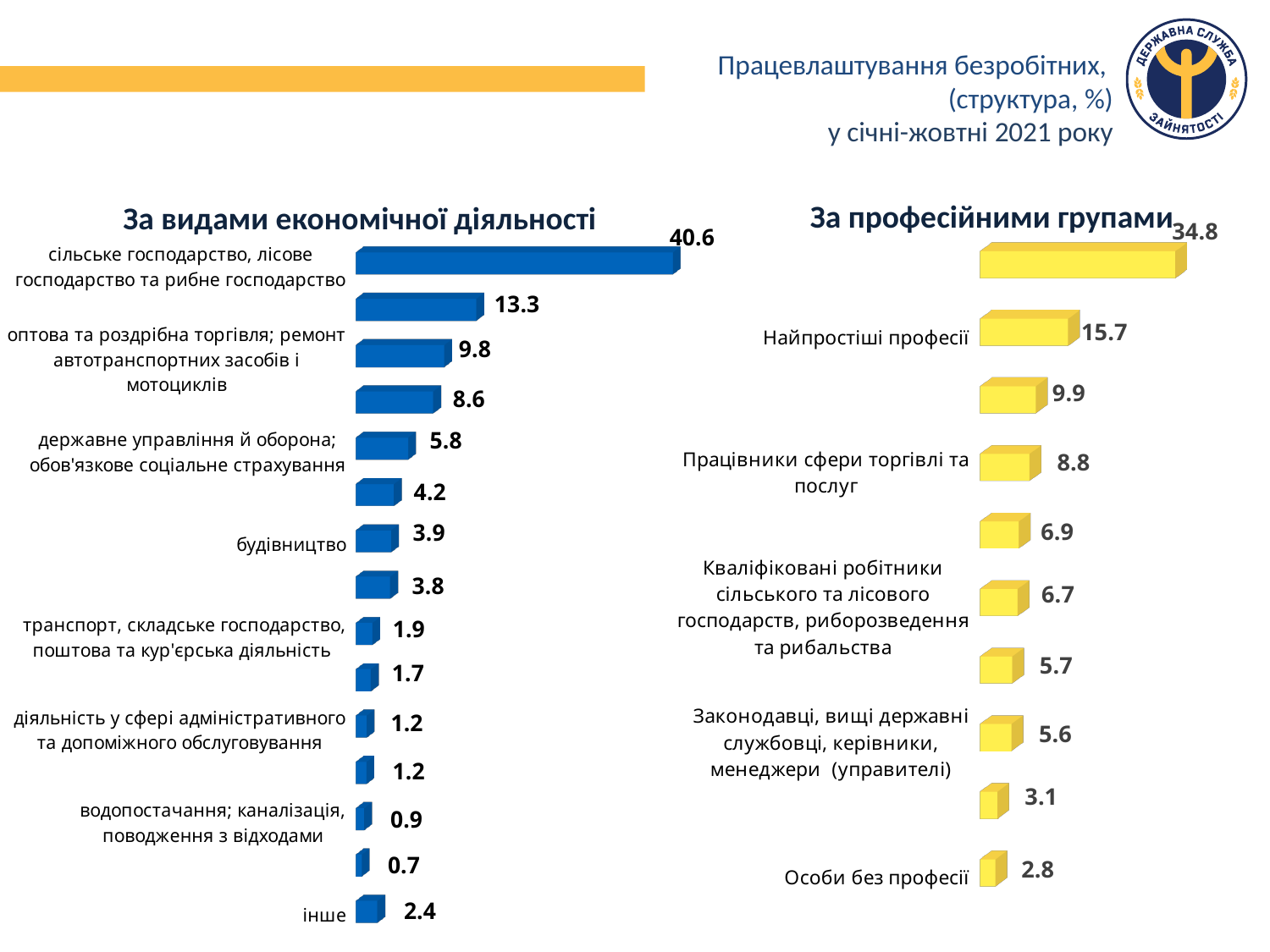
In the chart 'За професійними групами', what is the value for 'Особи без професії'? 2.8 How many bars are plotted in the chart 'За видами економічної діяльності'? 15 In the chart 'За професійними групами', what is the difference between the values for 'Працівники сфери торгівлі та послуг' and 'Законодавці, вищі державні службовці, керівники, менеджери (управителі)'? 3.2 In the chart 'За видами економічної діяльності', what is the value for 'будівництво'? 3.9 In the chart 'За професійними групами', what is the value for 'Найпростіші професії'? 15.7 What type of chart is 'За професійними групами'? bar chart In the chart 'За видами економічної діяльності', what is the value for 'сільське господарство, лісове господарство та рибне господарство'? 40.6 In the chart 'За видами економічної діяльності', which category has the highest value? сільське господарство, лісове господарство та рибне господарство In the chart 'За видами економічної діяльності', what is the value for 'інше'? 2.4 How many bars are plotted in the chart 'За професійними групами'? 10 In the chart 'За видами економічної діяльності', which is larger: 'транспорт, складське господарство, поштова та кур'єрська діяльність' or 'водопостачання; каналізація, поводження з відходами'? транспорт, складське господарство, поштова та кур'єрська діяльність In the chart 'За видами економічної діяльності', what is the difference between the values for 'оптова та роздрібна торгівля; ремонт автотранспортних засобів і мотоциклів' and 'державне управління й оборона; обов'язкове соціальне страхування'? 4.0